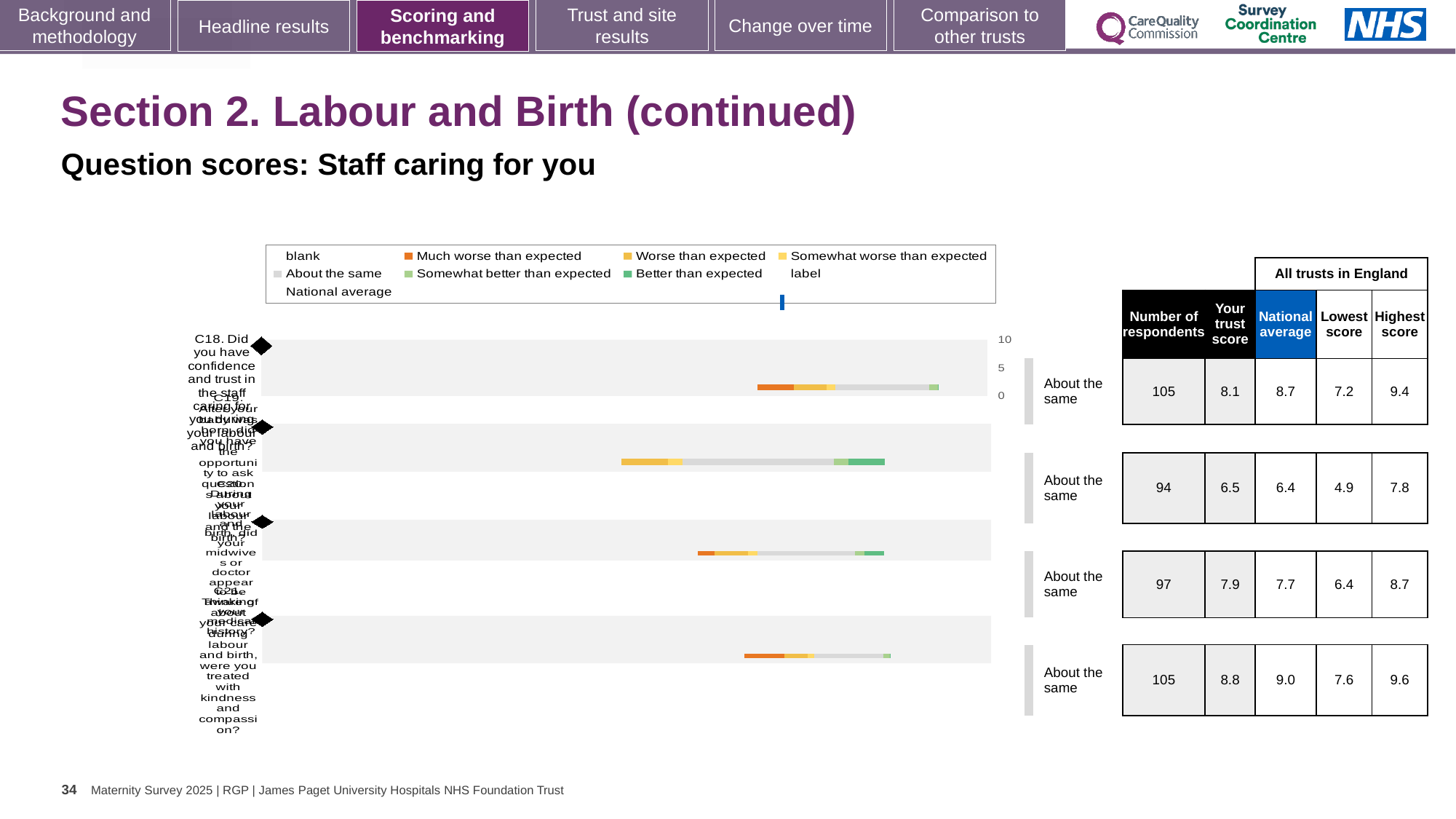
What is the 'Your trust score' value for question C18 (confidence and trust in the staff caring for you)? 8.1 What benchmark category is shown for all four questions in the chart? About the same What kind of chart is used to show the question scores on this slide? bar chart Which question has the lowest 'Your trust score'? C19 For question C18, what is the difference between the highest score and the lowest score across all trusts in England? 2.2 Which question has the highest 'Your trust score'? C21 How many questions (bars) are plotted in the chart? 4 For question C20, which is larger: the trust score or the national average? the trust score What is the lowest score across all trusts in England for question C19? 4.9 How many respondents are listed for question C21? 105 For question C21, how much higher is the national average than the trust score? 0.2 What is the national average score for question C19? 6.4